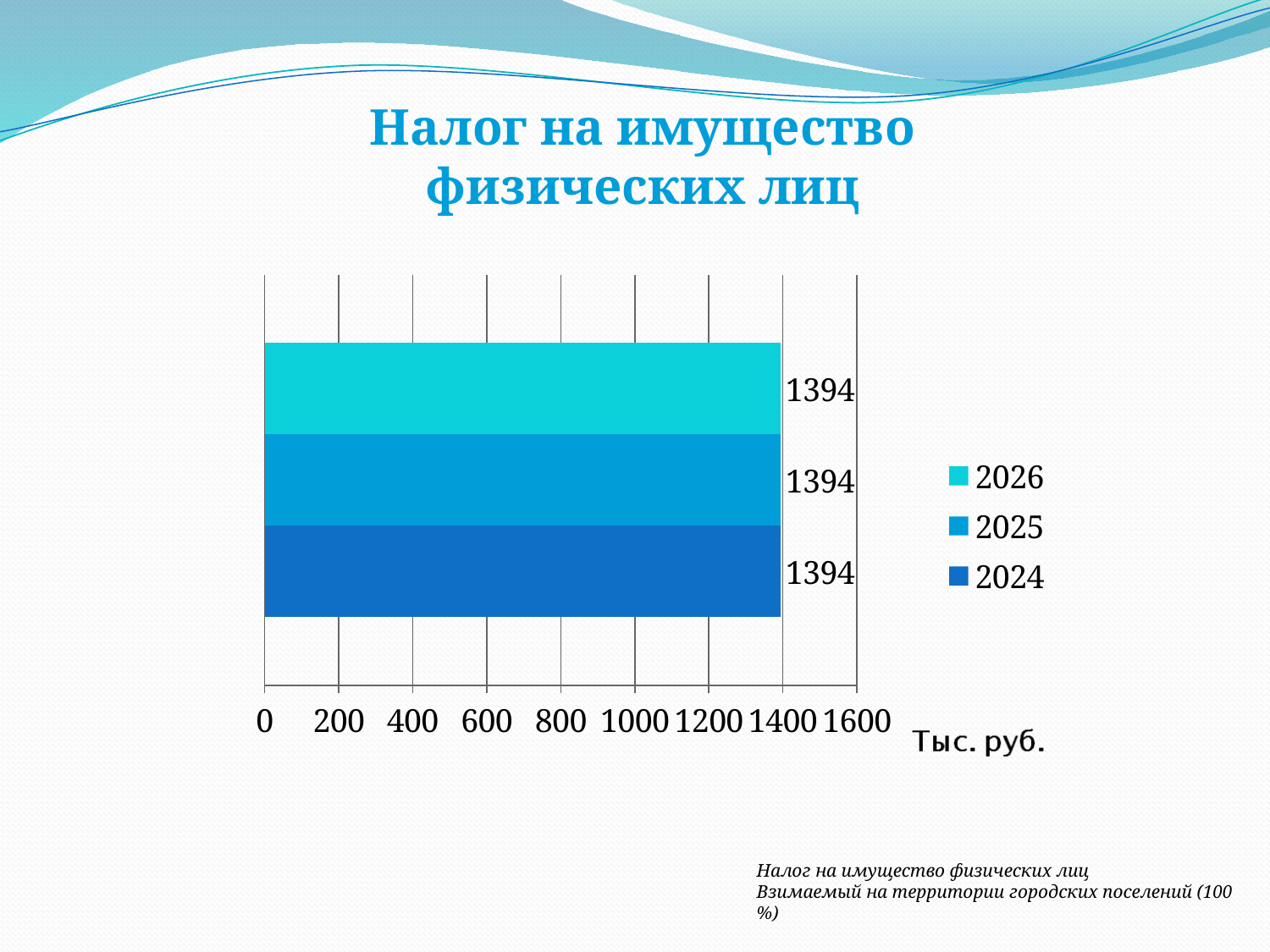
How many bars are plotted on the chart? 3 Is the value for 2026 greater or less than 1200? greater What is the value for 2026? 1394 What is the title of the chart? Налог на имущество физических лиц What is the value for 2025? 1394 What kind of chart is shown on the slide? bar chart What is the value for 2024? 1394 How many series does the legend list? 3 What is the difference between the values for 2026 and 2024? 0 What unit is shown on the horizontal axis? Тыс. руб. Is the value for 2025 larger than, smaller than, or equal to the value for 2024? equal Is the value for 2024 greater or less than 1600? less